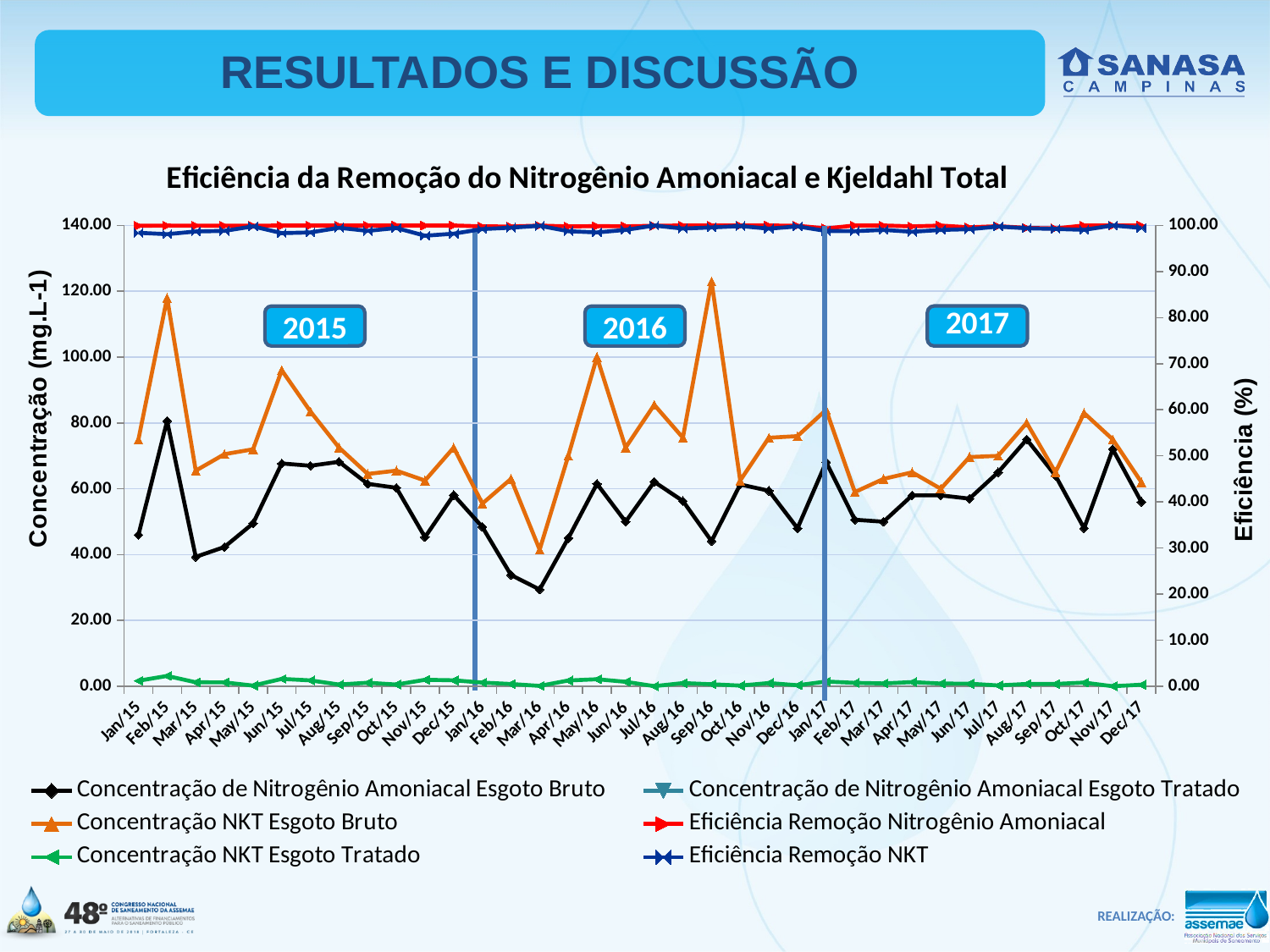
Is the Concentração NKT Esgoto Tratado value for Jan/15 greater or less than 20.00? less In which month does the Concentração de Nitrogênio Amoniacal Esgoto Bruto series reach its lowest value? Mar/16 What is the label of the right-hand vertical axis? Eficiência (%) What kind of chart is shown on the slide? line chart Is the Concentração de Nitrogênio Amoniacal Esgoto Bruto value for Mar/16 greater or less than 40.00? less How many months are plotted along the x axis? 36 Is the Concentração NKT Esgoto Bruto value for Feb/15 greater or less than 100.00? greater In which month does the Concentração de Nitrogênio Amoniacal Esgoto Bruto series reach its highest value? Feb/15 How many series does the legend list? 6 In Jan/15, which is higher: Concentração NKT Esgoto Bruto or Concentração de Nitrogênio Amoniacal Esgoto Bruto? Concentração NKT Esgoto Bruto What is the title of the chart? Eficiência da Remoção do Nitrogênio Amoniacal e Kjeldahl Total In which month does the Concentração NKT Esgoto Bruto series reach its highest value? Sep/16